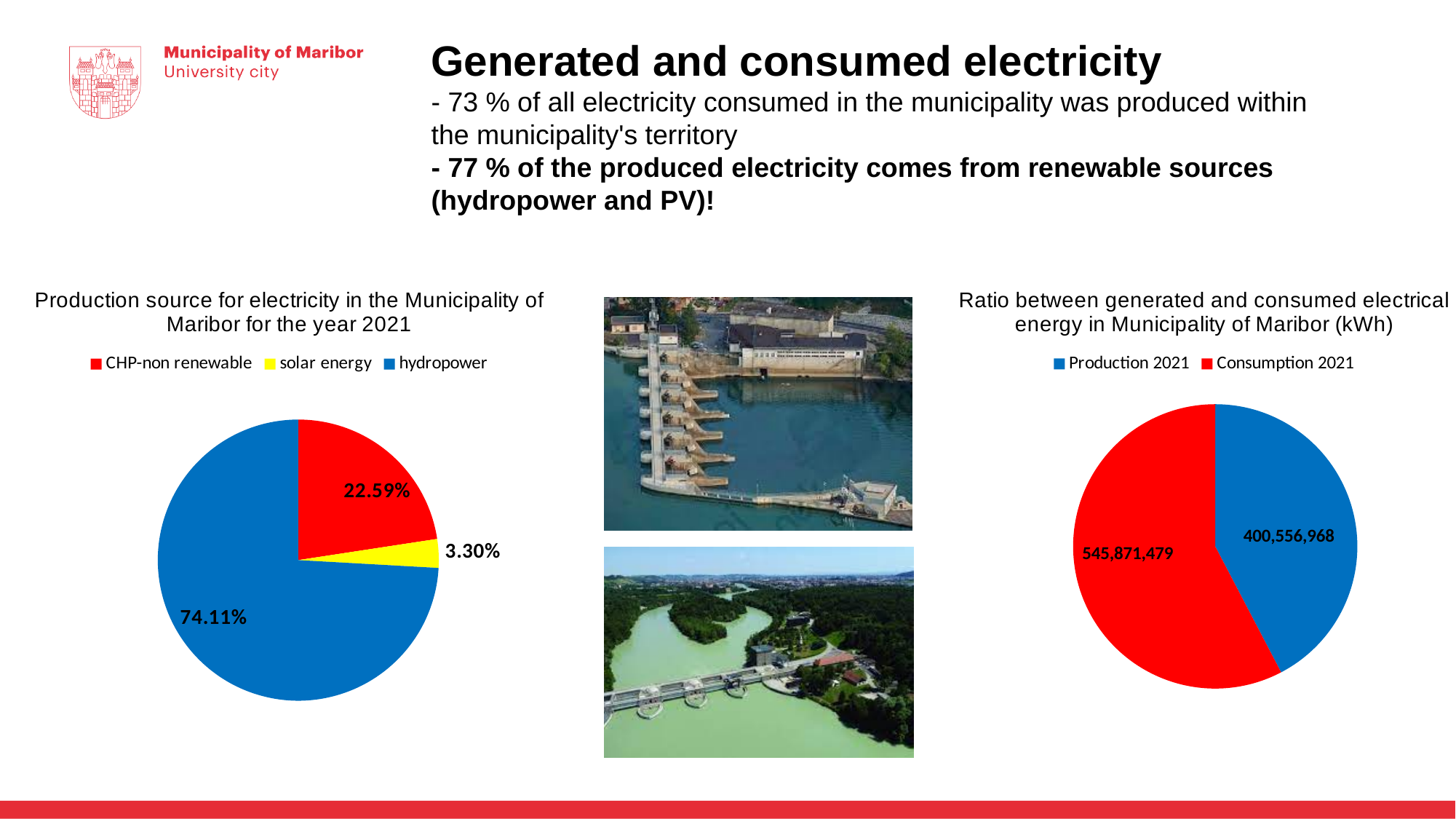
In the 'Ratio between generated and consumed electrical energy' pie chart, what is the value for Production 2021? 400,556,968 In the 'Production source for electricity' pie chart, which source has the smallest share? solar energy In the 'Production source for electricity' pie chart, how many categories are shown in the legend? 3 In the 'Ratio between generated and consumed electrical energy' pie chart, what is the value for Consumption 2021? 545,871,479 In the 'Production source for electricity' pie chart, how many percentage points larger is hydropower's share than CHP-non renewable's share? 51.52% In the 'Production source for electricity' pie chart, what share does solar energy have? 3.30% In the 'Ratio between generated and consumed electrical energy' pie chart, which is larger, Production 2021 or Consumption 2021? Consumption 2021 In the 'Ratio between generated and consumed electrical energy' pie chart, what is the difference between Consumption 2021 and Production 2021? 145,314,511 In the 'Production source for electricity' pie chart, what share does hydropower have? 74.11% What type of chart is used for the 'Ratio between generated and consumed electrical energy' chart? pie chart In the 'Production source for electricity' pie chart, which source has the largest share? hydropower In the 'Production source for electricity' pie chart, what share does CHP-non renewable have? 22.59%